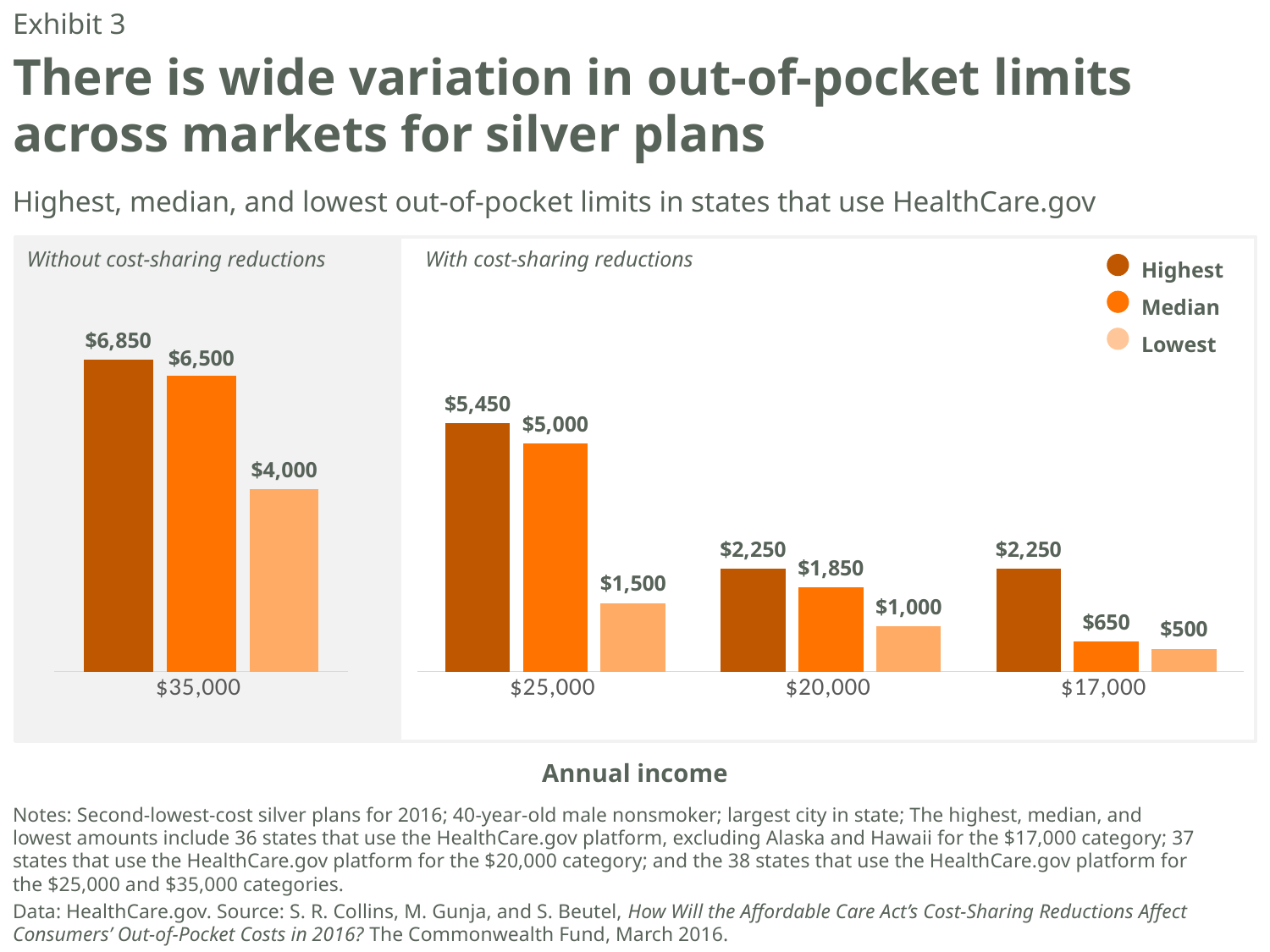
Do the Median out-of-pocket limits rise or fall moving from $35,000 to $17,000 along the x axis? Fall What is the Median out-of-pocket limit for the $20,000 annual income category? $1,850 How many series does the legend list? 3 What is the difference between the Highest and Lowest out-of-pocket limits for the $25,000 category? $3,950 Which annual income category has the highest Lowest-series out-of-pocket limit? $35,000 What kind of chart is shown on the slide? Bar chart What is the Lowest out-of-pocket limit for the $17,000 annual income category? $500 What is the Median out-of-pocket limit for the $25,000 annual income category? $5,000 How many annual income categories are shown on the chart? 4 Which is larger: the Median limit for $20,000 or the Median limit for $17,000? $20,000 Which annual income category has the lowest Median out-of-pocket limit? $17,000 What is the Highest out-of-pocket limit for the $35,000 annual income category? $6,850